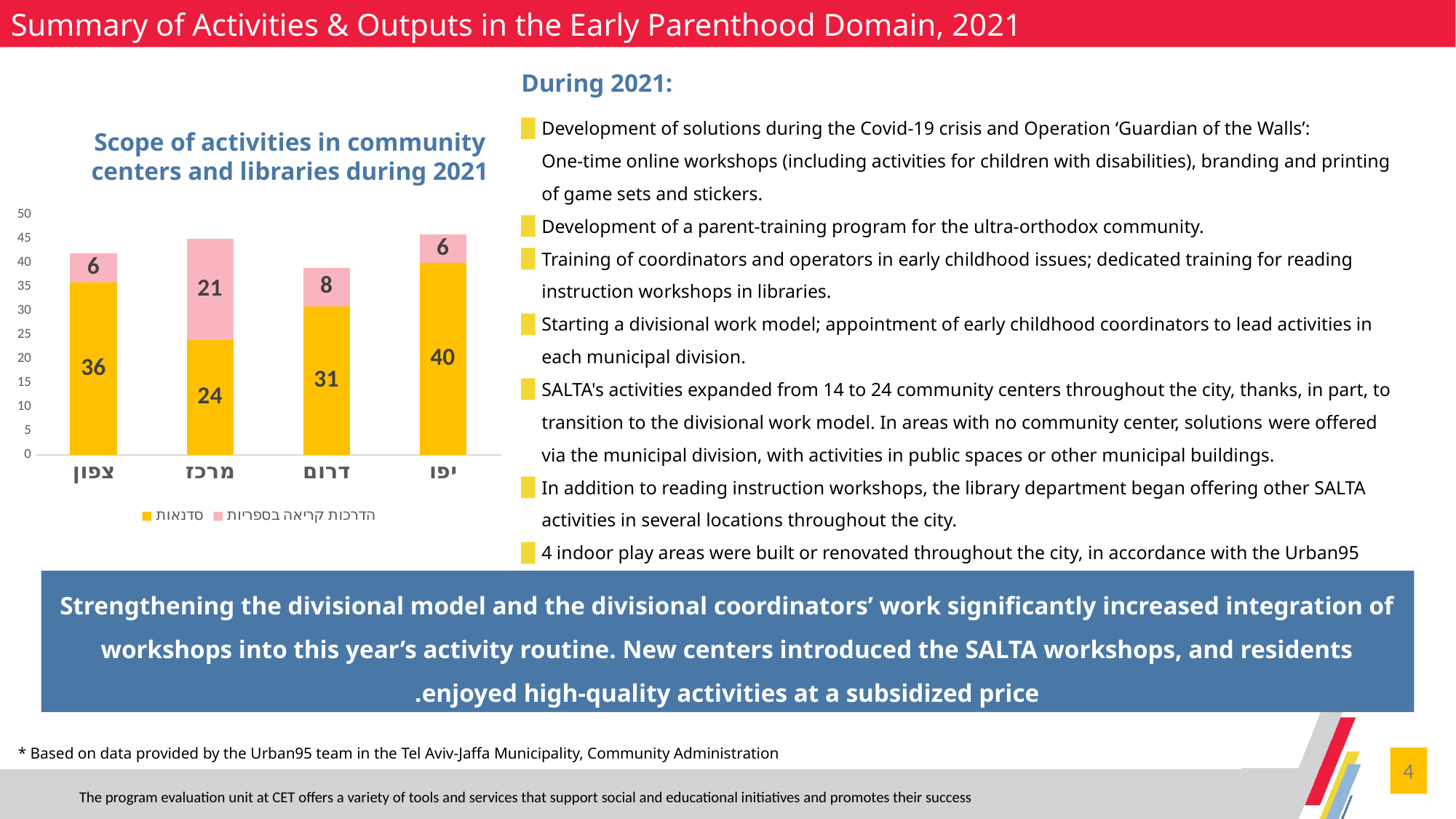
What is the value of the yellow (סדנאות) segment for דרום? 31 How many categories are shown on the x axis of the chart? 4 Which category has the lowest value for the yellow (סדנאות) series? מרכז How many series does the chart's legend list? 2 Which is larger: the pink (הדרכות קריאה בספריות) value for דרום or for צפון? דרום What is the value of the yellow (סדנאות) segment for יפו? 40 What is the value of the pink (הדרכות קריאה בספריות) segment for מרכז? 21 What is the difference between the yellow (סדנאות) values for יפו and צפון? 4 Which category has the highest value for the yellow (סדנאות) series? יפו What is the total of the stacked bar for מרכז? 45 What kind of chart is shown under the title 'Scope of activities in community centers and libraries during 2021'? Stacked bar chart What is the total of the stacked bar for צפון? 42